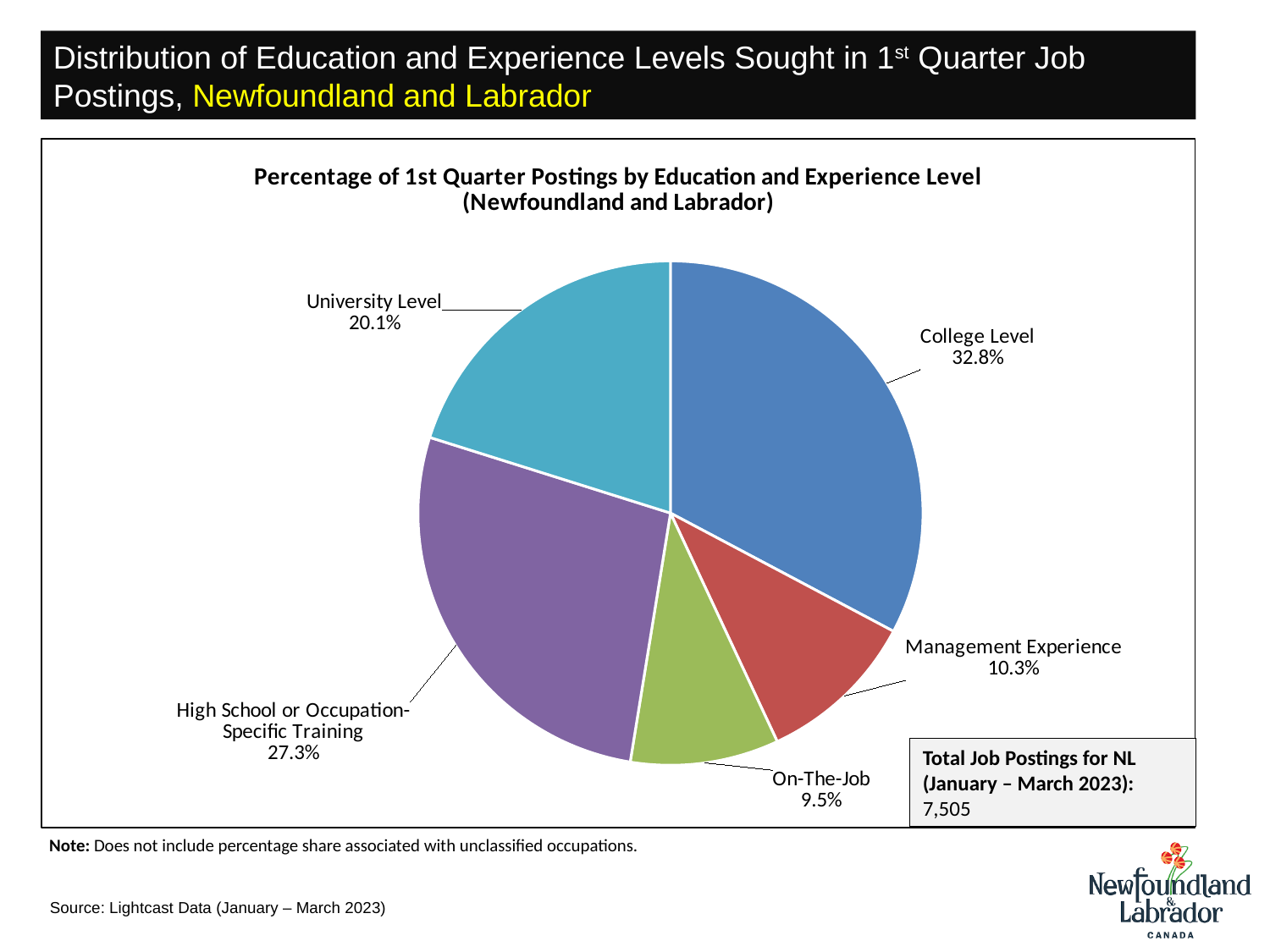
What percentage of postings sought High School or Occupation-Specific Training? 27.3% What share of postings sought University Level education? 20.1% What is the total number of job postings for NL shown in the box on the chart? 7,505 Which has a larger share, Management Experience or On-The-Job? Management Experience Which education or experience level has the largest share of postings? College Level How many slices does the pie chart have? 5 What type of chart is shown on the slide? Pie chart What is the difference in percentage points between College Level and University Level? 12.7 What percentage of 1st quarter postings sought College Level education? 32.8% What percentage of postings sought On-The-Job training? 9.5% Which education or experience level has the smallest share of postings? On-The-Job What percentage of postings sought Management Experience? 10.3%